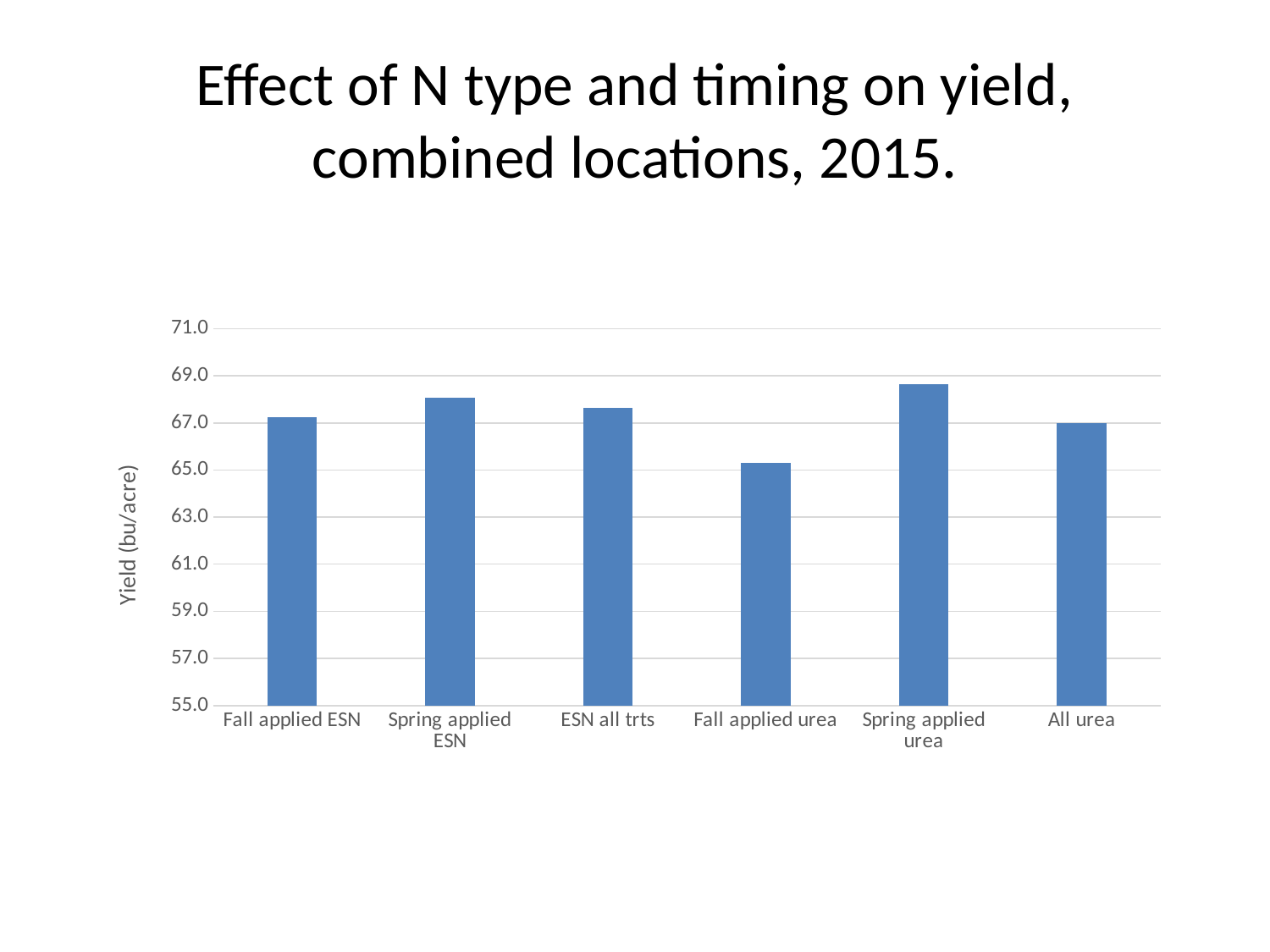
What kind of chart is shown on the slide? bar chart How many categories are shown on the x axis of the chart? 6 Which category has the highest yield? Spring applied urea What is the title of the slide? Effect of N type and timing on yield, combined locations, 2015. Is the yield for Fall applied ESN greater or less than 65.0? greater Is the yield for Spring applied ESN greater or less than 69.0? less Is the yield for Fall applied urea greater or less than 67.0? less Which category has the lowest yield? Fall applied urea Which has the larger yield, Fall applied ESN or Fall applied urea? Fall applied ESN Which has the larger yield, Fall applied urea or Spring applied ESN? Spring applied ESN What is the label of the y axis? Yield (bu/acre)